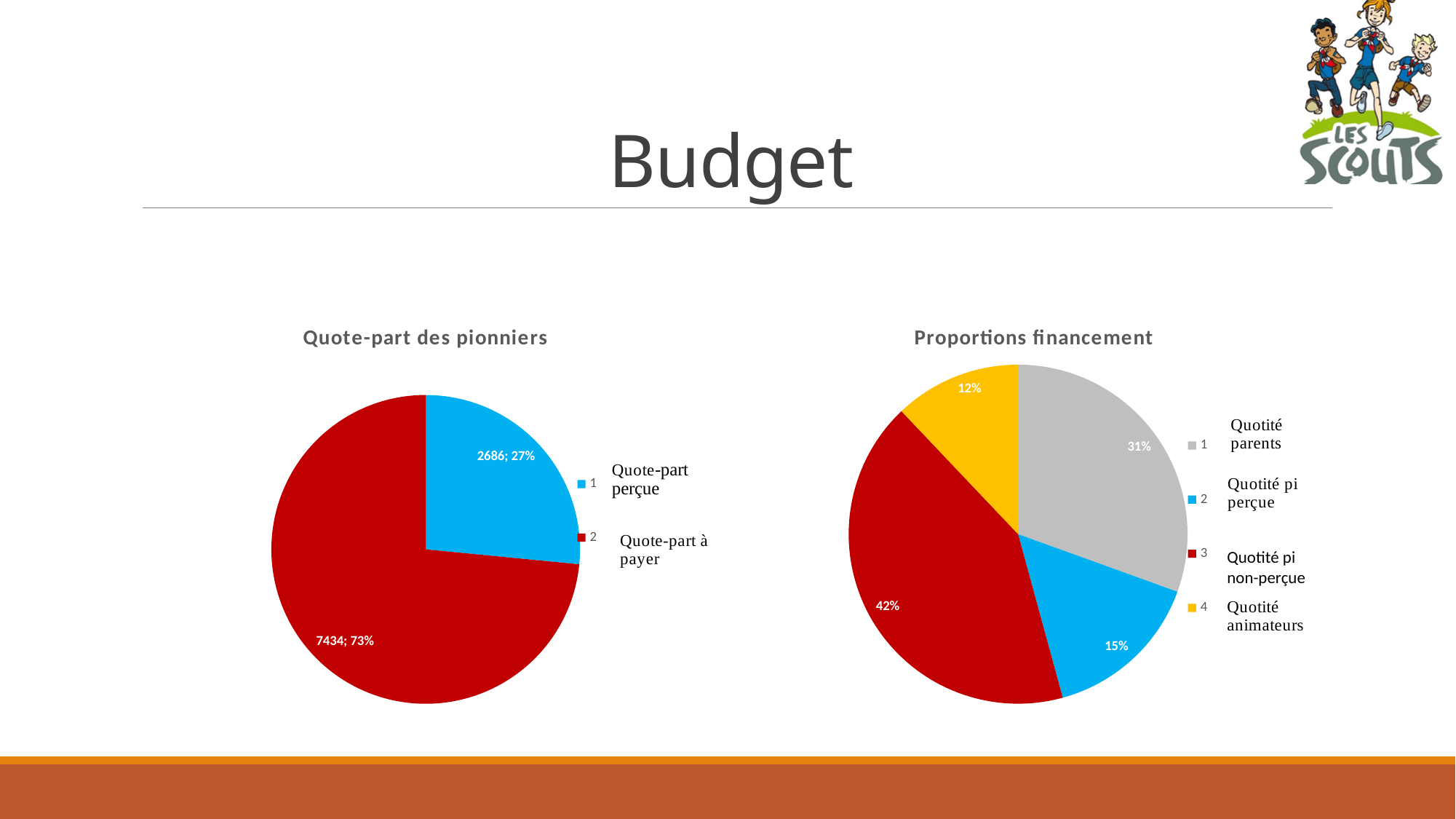
In the 'Proportions financement' chart, which category has the largest share? Quotité pi non-perçue In the 'Quote-part des pionniers' chart, which slice is larger, 'Quote-part perçue' or 'Quote-part à payer'? Quote-part à payer How many slices does the 'Proportions financement' pie chart have? 4 In the 'Proportions financement' chart, which category has the smallest share? Quotité animateurs What kind of chart is 'Proportions financement'? Pie chart In the 'Proportions financement' chart, what is the difference in percentage points between 'Quotité pi non-perçue' and 'Quotité pi perçue'? 27 In the 'Quote-part des pionniers' chart, what value is shown for 'Quote-part à payer'? 7434; 73% In the 'Quote-part des pionniers' chart, what share of the pie is 'Quote-part à payer'? 73% In the 'Quote-part des pionniers' chart, what is the difference between the 'Quote-part à payer' value and the 'Quote-part perçue' value? 4748 In the 'Proportions financement' chart, what percentage is shown for 'Quotité animateurs'? 12% In the 'Quote-part des pionniers' chart, what value is shown for 'Quote-part perçue'? 2686; 27% In the 'Proportions financement' chart, what percentage is shown for 'Quotité parents'? 31%